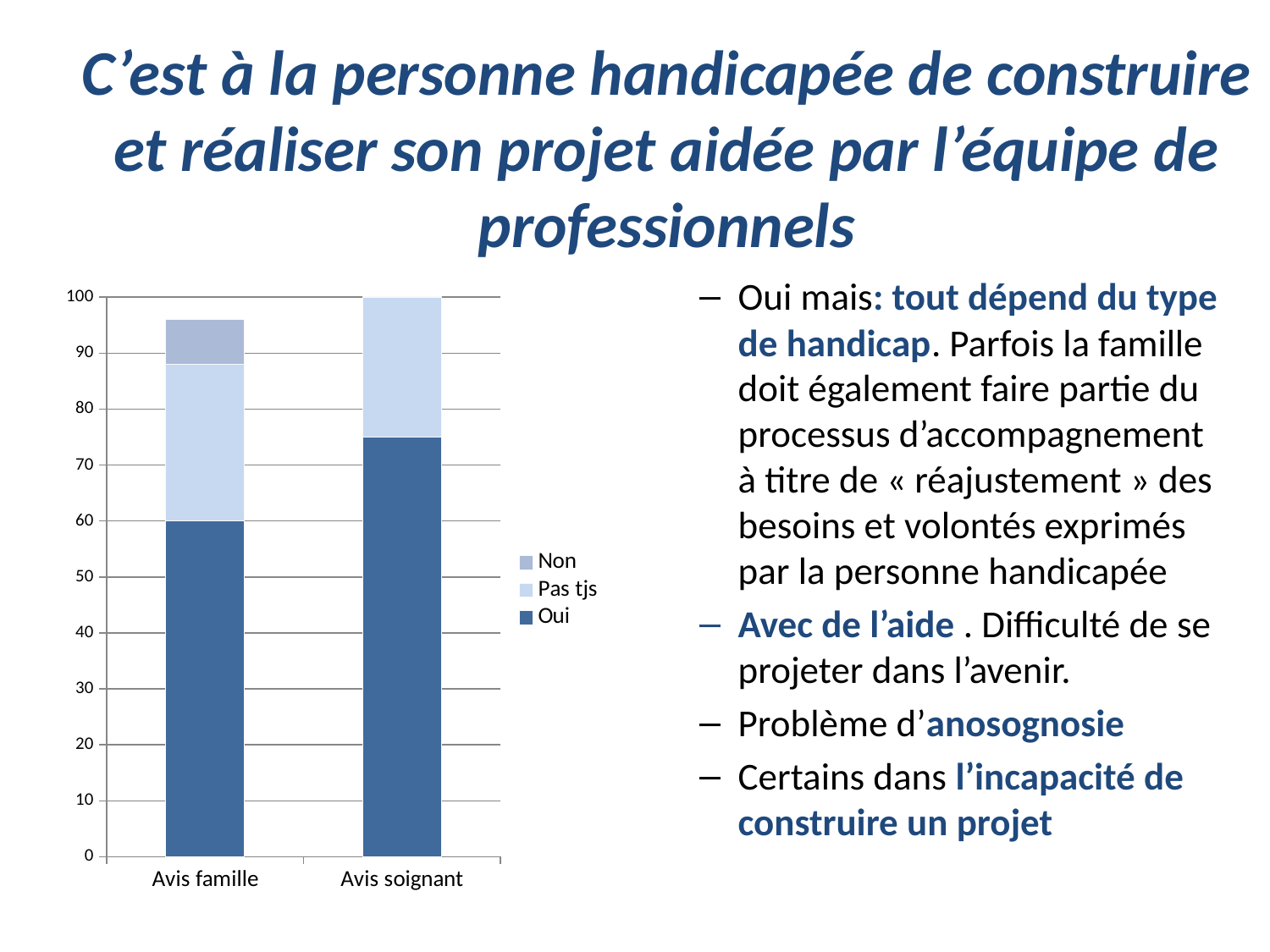
Is the total height of the Avis famille bar greater or less than 90? greater Which category includes a Non segment? Avis famille What kind of chart is shown on the slide? stacked bar chart Which category has the larger Oui segment, Avis famille or Avis soignant? Avis soignant How many series does the chart legend list? 3 Which series are listed in the chart legend? Non, Pas tjs, Oui What is the total height of the stacked bar for Avis soignant? 100 Which category has the taller stacked bar overall? Avis soignant Is the Oui value for Avis soignant greater or less than 70? greater Is the Oui value for Avis soignant greater or less than 80? less What is the value of the Oui segment for Avis famille? 60 How many categories are shown on the x axis of the chart? 2